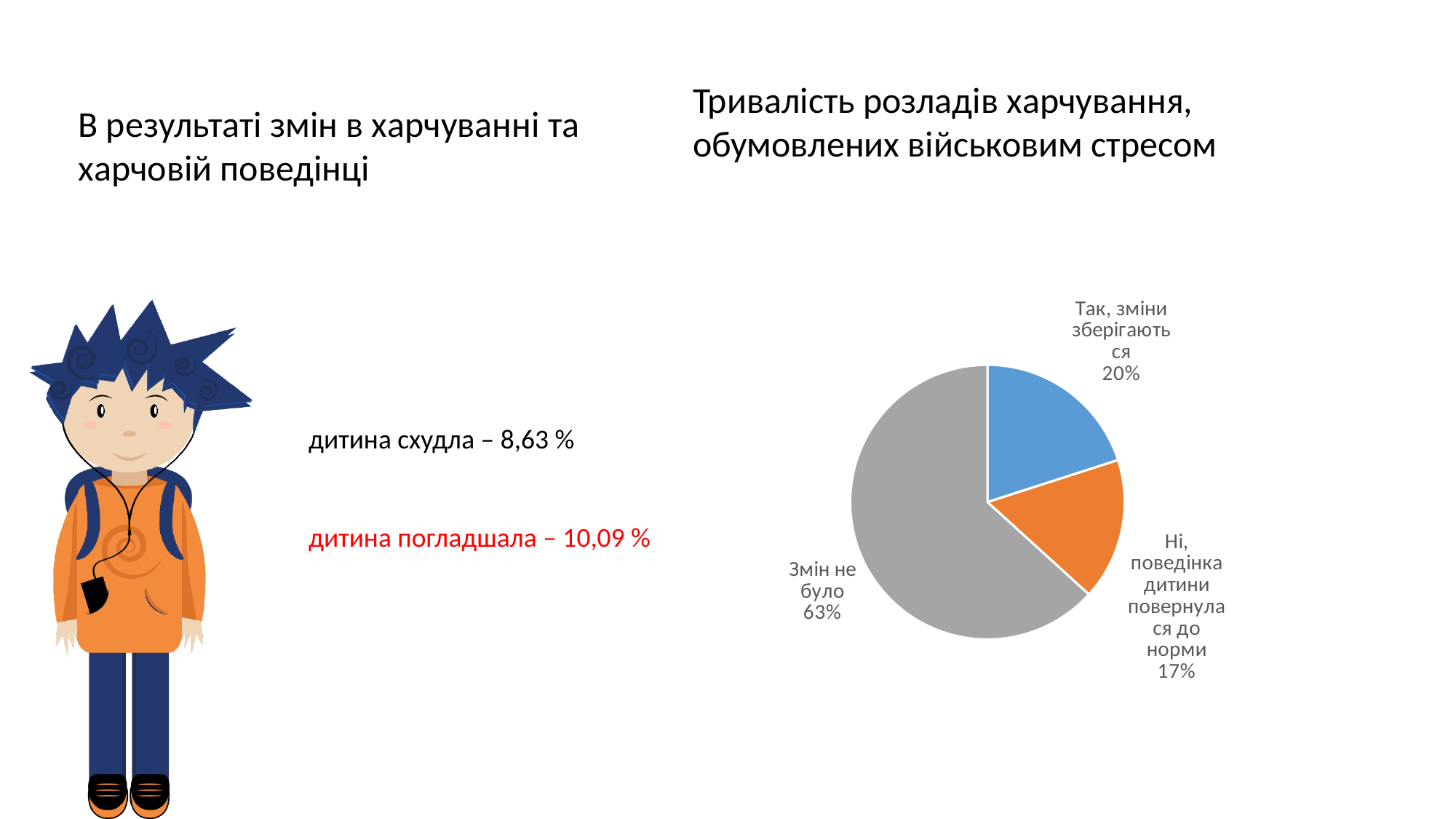
Which is larger: the share for "Так, зміни зберігаються" or for "Ні, поведінка дитини повернулася до норми"? Так, зміни зберігаються What share of the pie does "Ні, поведінка дитини повернулася до норми" represent? 17% Which slice of the pie is the largest? Змін не було How many slices does the pie chart have? 3 What is the difference between the shares for "Змін не було" and "Так, зміни зберігаються"? 43% What colour is the "Змін не було" slice of the pie? grey What share of the pie does "Змін не було" represent? 63% What is the title of the pie chart? Тривалість розладів харчування, обумовлених військовим стресом What kind of chart is shown on the slide? pie chart What share of the pie does "Так, зміни зберігаються" represent? 20% Which slice of the pie is the smallest? Ні, поведінка дитини повернулася до норми What is the difference between the shares for "Так, зміни зберігаються" and "Ні, поведінка дитини повернулася до норми"? 3%